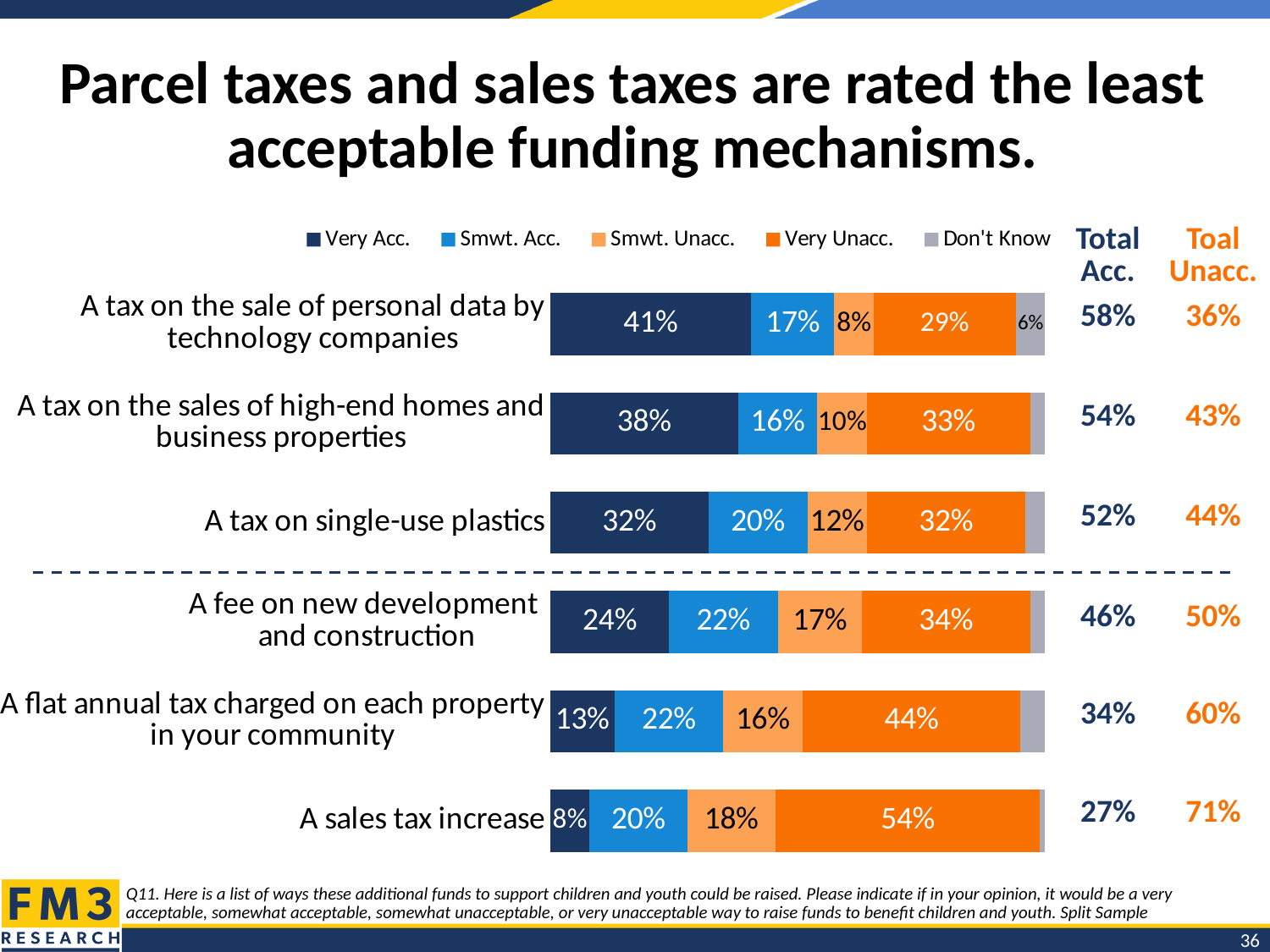
Which funding mechanism has the lowest Very Acc. percentage? A sales tax increase How many percentage points higher is the Very Unacc. value for a sales tax increase than for a flat annual tax charged on each property in your community? 10 percentage points What kind of chart is shown on the slide? Stacked bar chart Which has a larger Smwt. Acc. value: a tax on single-use plastics or a tax on the sales of high-end homes and business properties? A tax on single-use plastics How many series does the legend list? 5 How many funding mechanisms are shown in the chart? 6 What is the Don't Know value for a tax on the sale of personal data by technology companies? 6% What percentage rated a sales tax increase as Very Unacc.? 54% What is the Total Acc. value for a fee on new development and construction? 46% Which funding mechanism has the highest Very Unacc. percentage? A sales tax increase What percentage rated a tax on single-use plastics as Very Acc.? 32% What is the difference in Total Unacc. between a sales tax increase and a tax on the sale of personal data by technology companies? 35 percentage points